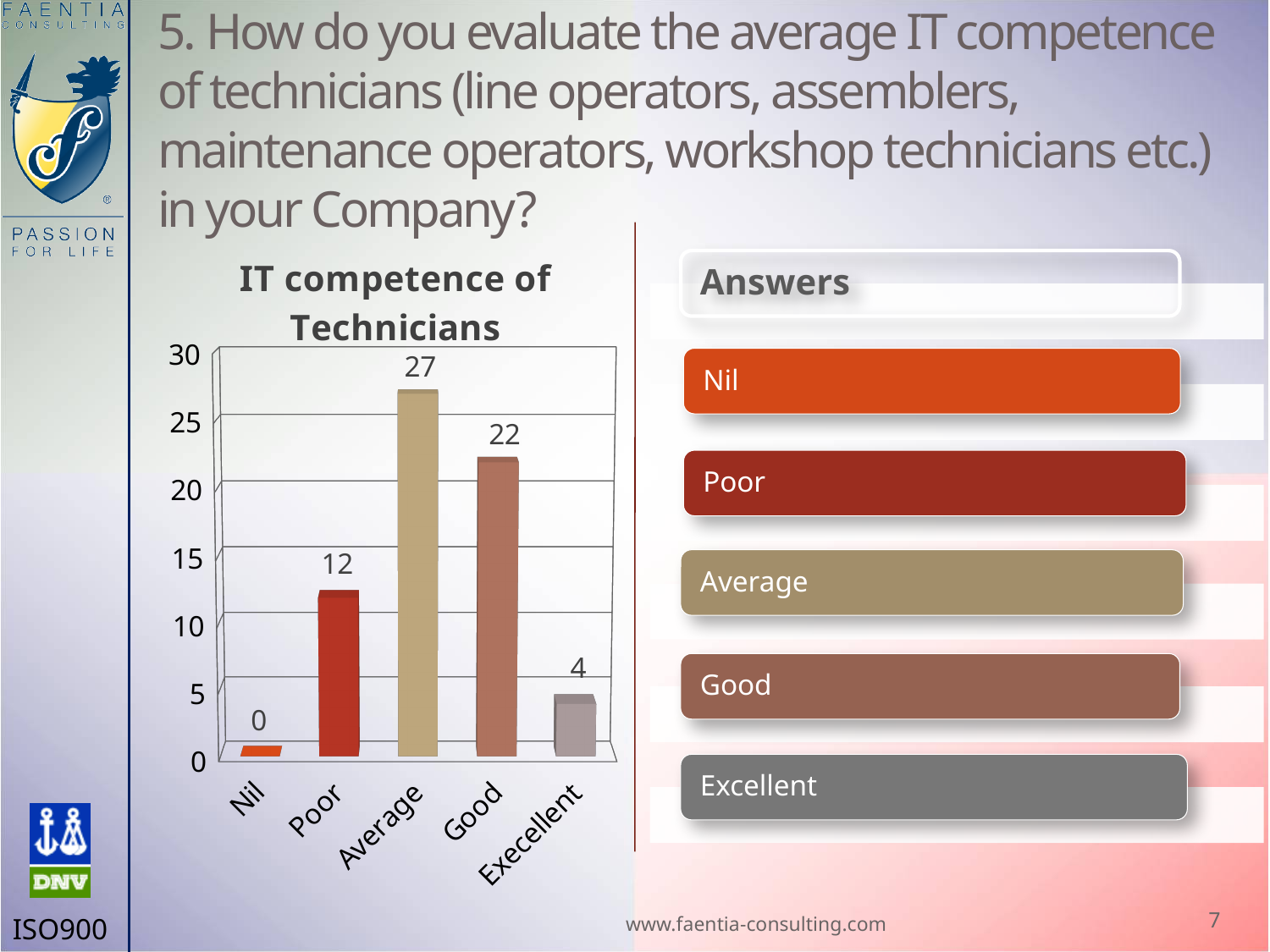
What is the value for Nil in the IT competence of Technicians chart? 0 Is the value for Good in the IT competence of Technicians chart greater or less than 20? greater What is the value for Average in the IT competence of Technicians chart? 27 What is the title of the chart on the slide? IT competence of Technicians What is the value for Poor in the IT competence of Technicians chart? 12 Which category has the highest value in the IT competence of Technicians chart? Average What kind of chart is the IT competence of Technicians chart? bar chart Which category has the lowest value in the IT competence of Technicians chart? Nil How many categories are shown in the IT competence of Technicians chart? 5 What is the difference between the values for Average and Good in the IT competence of Technicians chart? 5 What is the value for Good in the IT competence of Technicians chart? 22 Which is larger in the IT competence of Technicians chart, Poor or Excellent? Poor